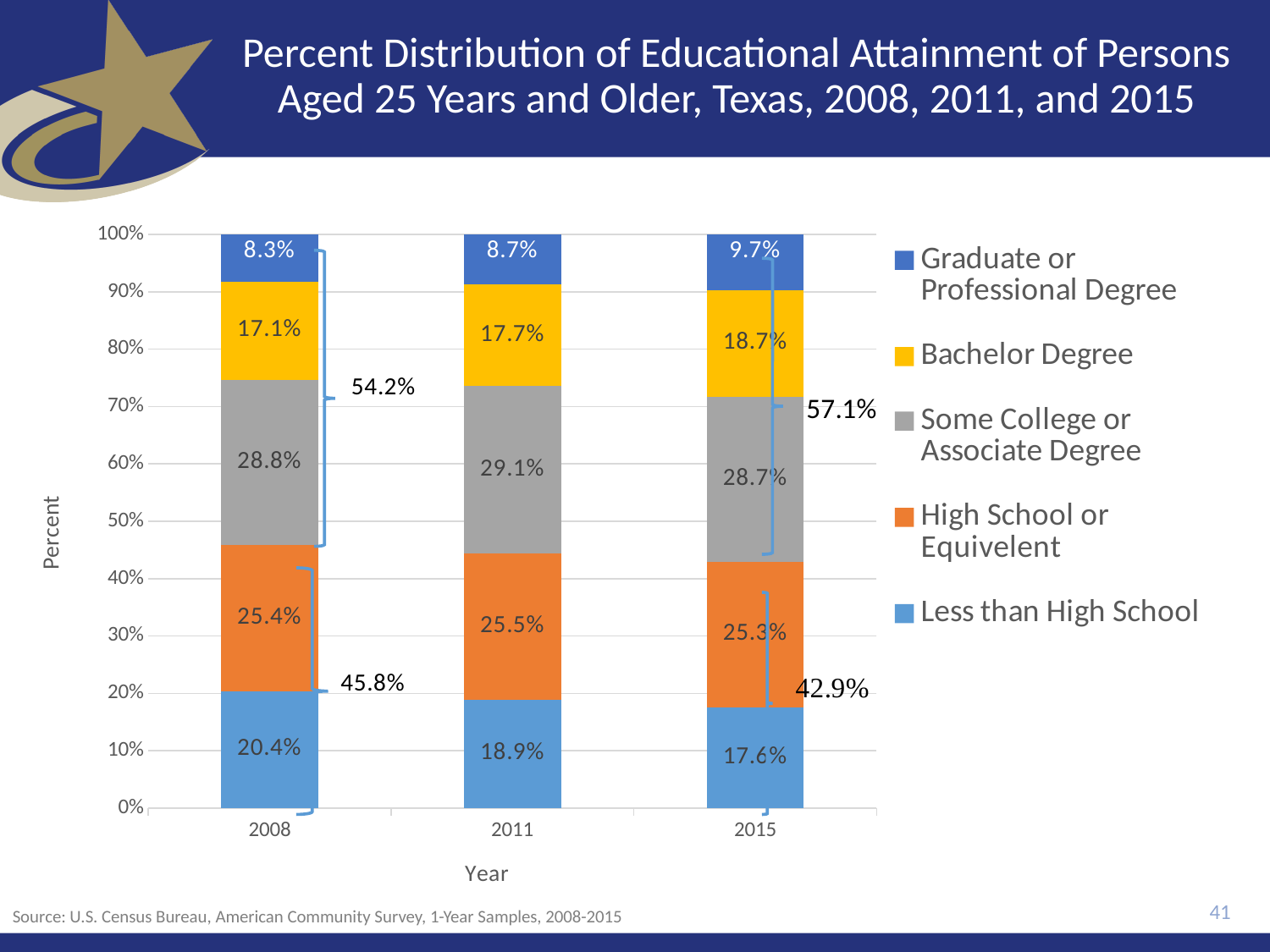
How many years (bars) are shown on the x axis? 3 In 2008, which is larger: the High School or Equivelent share or the Less than High School share? High School or Equivelent Does the Graduate or Professional Degree share rise or fall from 2008 to 2015? Rise How many series does the legend list? 5 In which year is the Graduate or Professional Degree share the highest? 2015 What combined percentage is annotated beside the 2015 bar for the top three segments (Some College or Associate Degree and above)? 57.1% What is the Graduate or Professional Degree percentage for 2011? 8.7% In which year is the Less than High School share the lowest? 2015 What kind of chart is shown on the slide? Stacked bar chart What is the Bachelor Degree percentage for 2015? 18.7% What is the Less than High School percentage for 2008? 20.4% By how many percentage points did the Less than High School share fall from 2008 to 2015? 2.8 percentage points